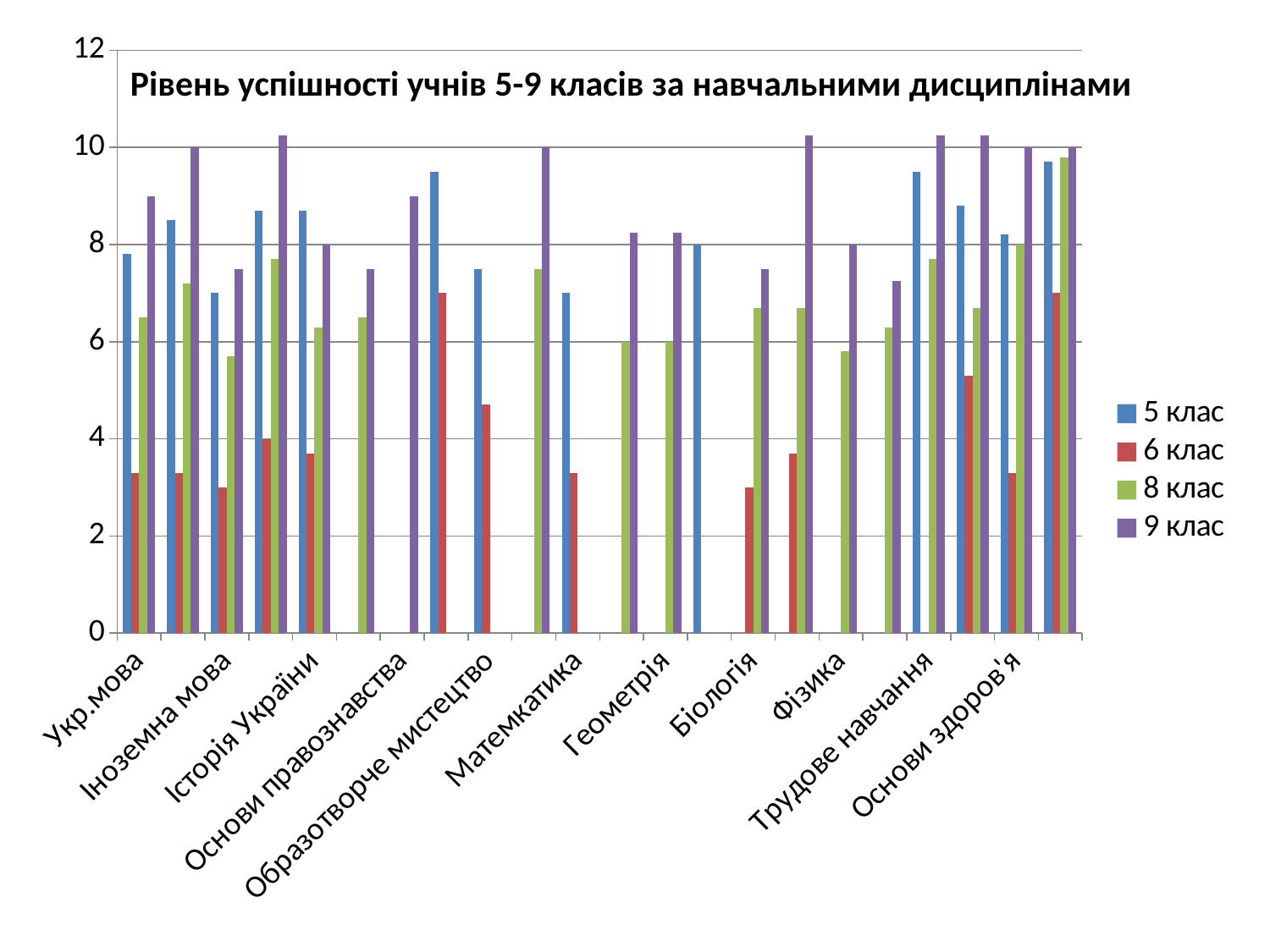
Is the value for 5 клас in Історія України greater or less than 8? greater Which series are listed in the legend? 5 клас, 6 клас, 8 клас, 9 клас Is the value for 9 клас in Іноземна мова greater or less than 6? greater In Трудове навчання, which is larger: the value for 8 клас or the value for 9 клас? 9 клас Is the value for 5 клас in Укр.мова greater or less than 6? greater What is the title of the chart? Рівень успішності учнів 5-9 класів за навчальними дисциплінами In Укр.мова, which is larger: the value for 5 клас or the value for 6 клас? 5 клас How many series does the legend list? 4 What kind of chart is shown on the slide? bar chart